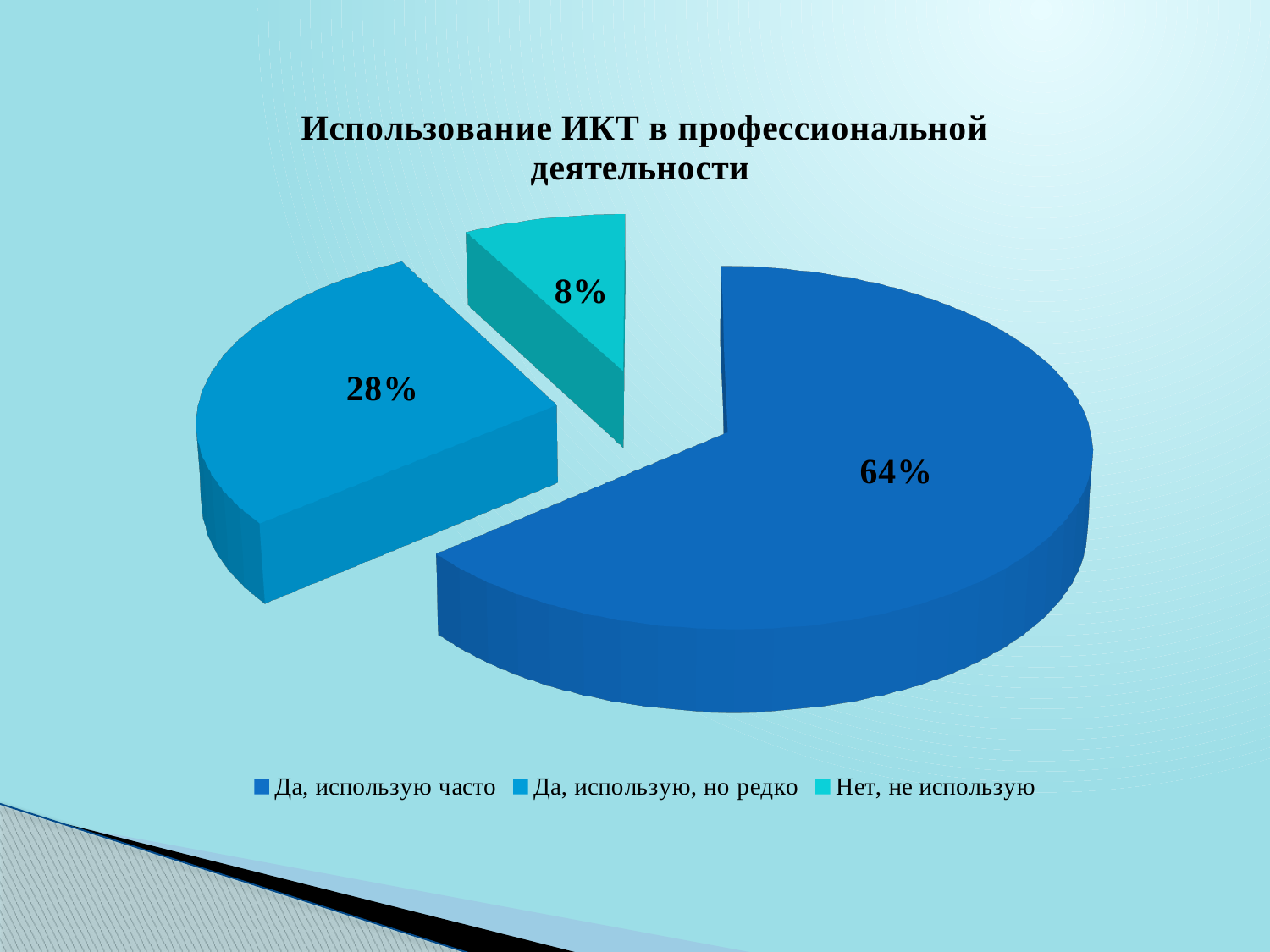
How many entries does the legend list? 3 How many slices does the pie chart have? 3 What share of the pie is labelled "Нет, не использую"? 8% Which category has the smallest slice of the pie? Нет, не использую What is the difference in percentage points between "Да, использую часто" and "Да, использую, но редко"? 36 Which is larger: the slice for "Да, использую, но редко" or the slice for "Нет, не использую"? Да, использую, но редко Which category has the largest slice of the pie? Да, использую часто What is the difference in percentage points between "Да, использую, но редко" and "Нет, не использую"? 20 What is the title of the chart? Использование ИКТ в профессиональной деятельности What kind of chart is shown on the slide? pie chart What share of the pie is labelled "Да, использую часто"? 64% What share of the pie is labelled "Да, использую, но редко"? 28%